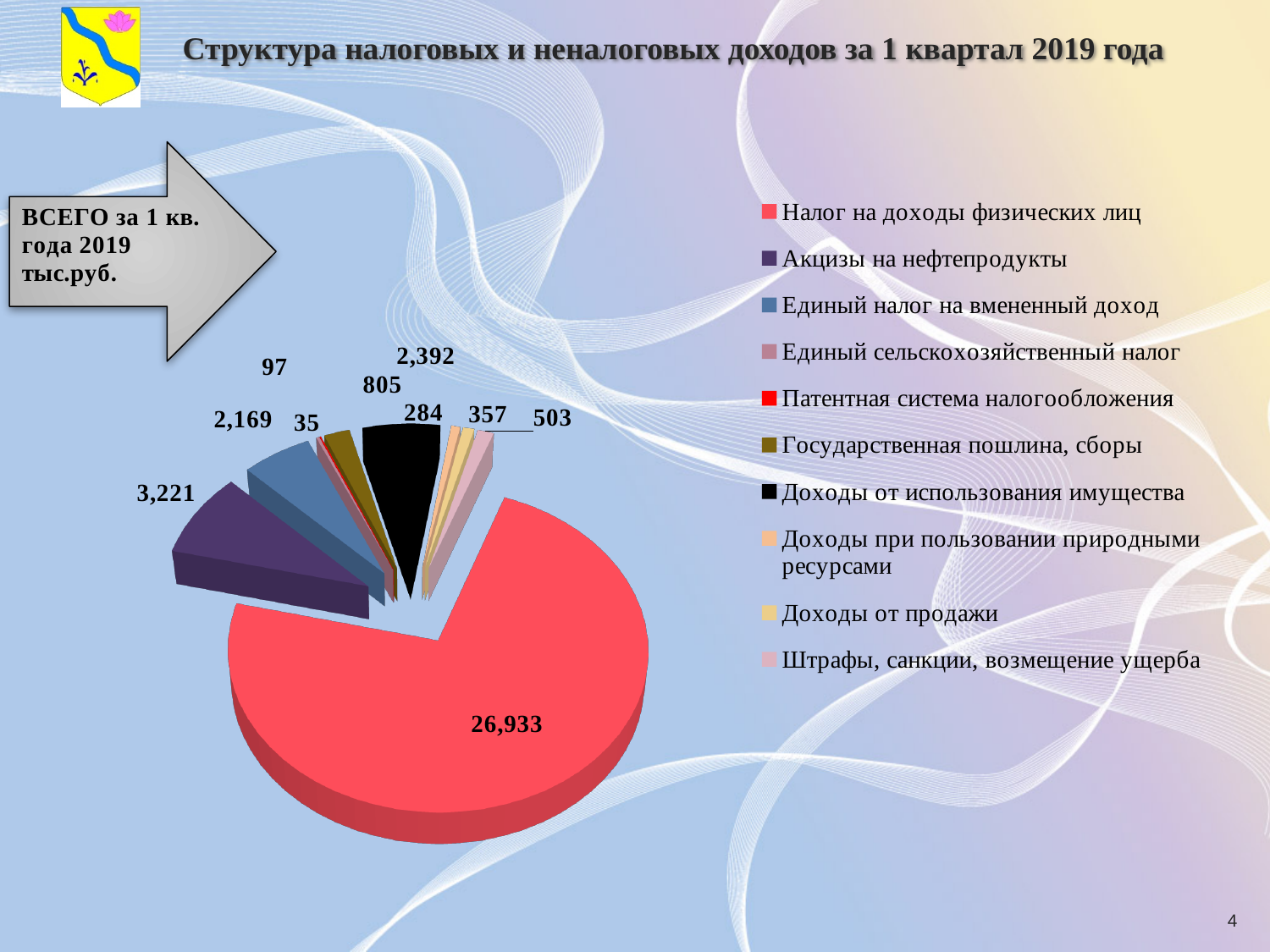
What is the title of the slide's chart? Структура налоговых и неналоговых доходов за 1 квартал 2019 года How many categories does the legend list? 10 What is the difference between Акцизы на нефтепродукты and Единый налог на вмененный доход? 1,052 What is the value for Доходы от использования имущества? 2,392 What is the value for Единый налог на вмененный доход? 2,169 What colour is the slice for Доходы от использования имущества? Black Which is larger: Акцизы на нефтепродукты or Единый налог на вмененный доход? Акцизы на нефтепродукты What is the value for Государственная пошлина, сборы? 805 What is the value for Налог на доходы физических лиц? 26,933 Which category has the largest slice of the pie? Налог на доходы физических лиц What kind of chart is shown on the slide? Pie chart What is the value for Акцизы на нефтепродукты? 3,221